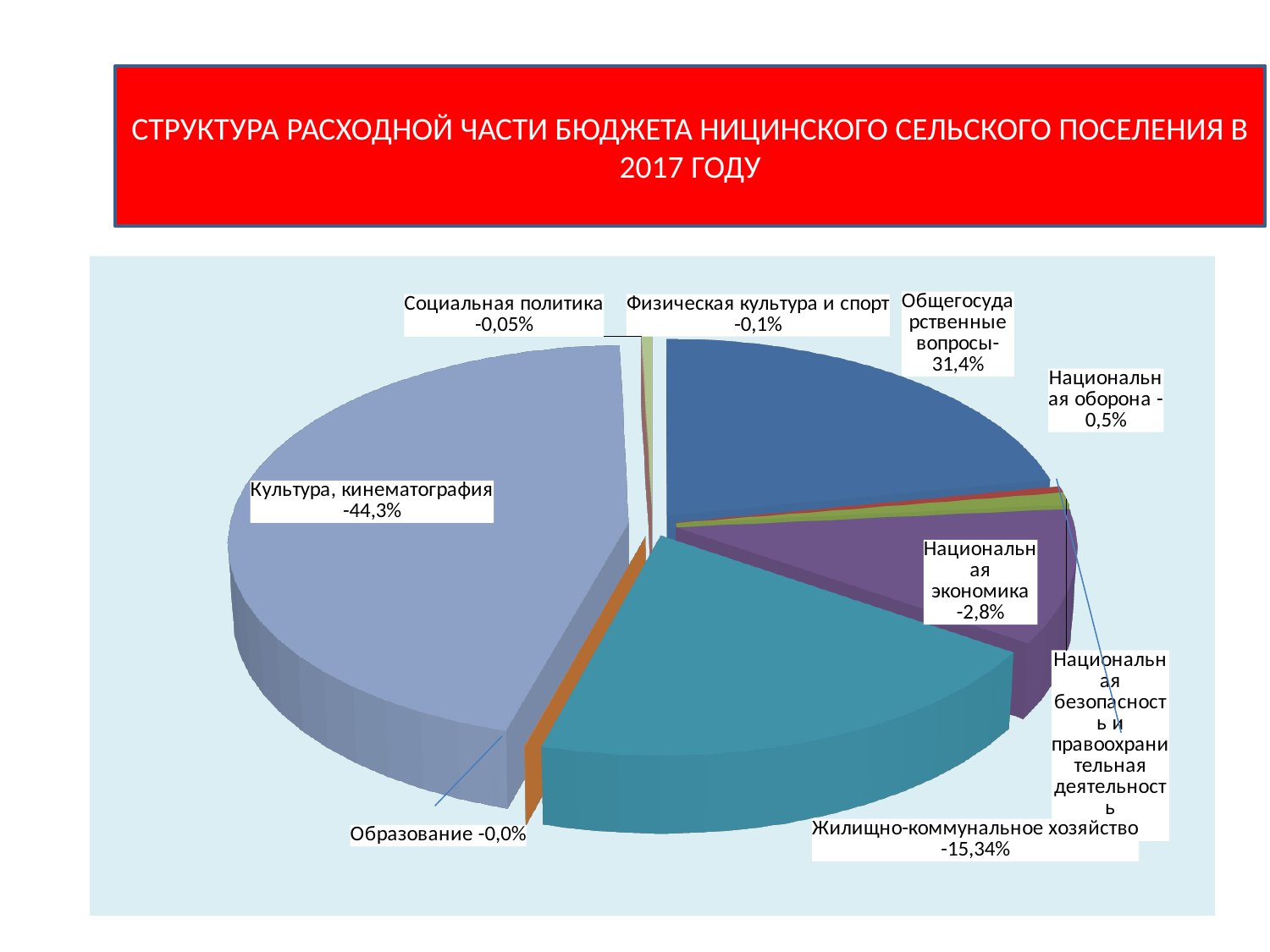
What share is labelled for Жилищно-коммунальное хозяйство? 15,34% How many categories are labelled on the pie chart? 9 Which labelled category has the smallest share, at 0,0%? Образование What share is labelled for Национальная оборона? 0,5% What share is labelled for Национальная экономика? 2,8% What kind of chart is shown on the slide? Pie chart What share is labelled for Социальная политика? 0,05% Which category has the largest share of the pie? Культура, кинематография What share of the budget expenditure is labelled for Культура, кинематография? 44,3% By how many percentage points does Культура, кинематография exceed Общегосударственные вопросы? 12,9% Which is larger: the share for Жилищно-коммунальное хозяйство or for Национальная экономика? Жилищно-коммунальное хозяйство What share is labelled for Общегосударственные вопросы? 31,4%